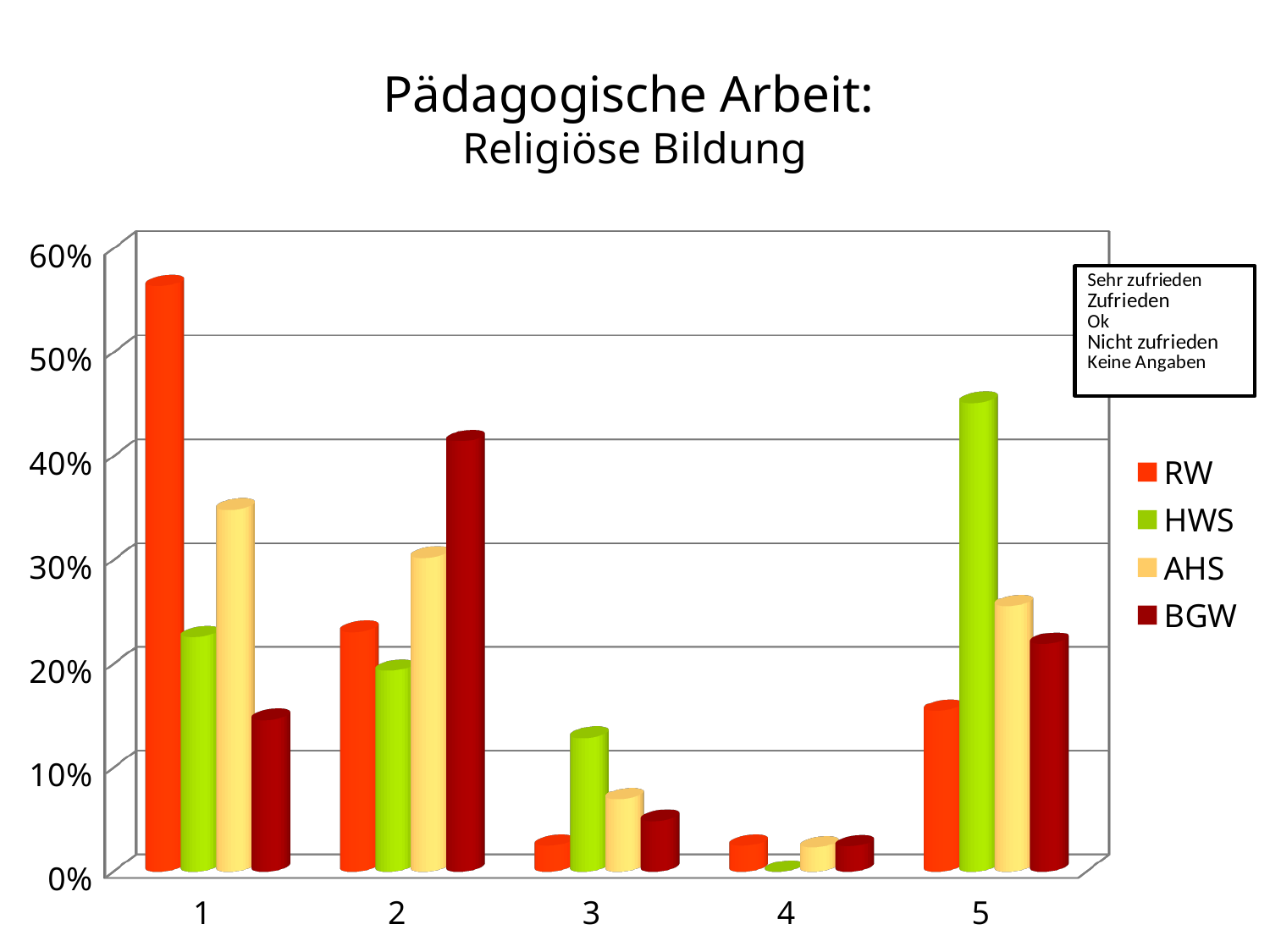
Which series has the highest value in category 5? HWS Which series has the highest value in category 2? BGW In category 5, which is larger: the value for AHS or the value for RW? AHS Is the value for RW in category 1 greater or less than 50%? greater How many categories are shown on the x axis? 5 Is the value for HWS in category 3 greater or less than 20%? less What kind of chart is shown on the slide? bar chart What is the title of the chart? Pädagogische Arbeit: Religiöse Bildung Which series has the lowest value in category 4? HWS Is the value for BGW in category 2 greater or less than 40%? greater Which series has the highest value in category 1? RW How many series does the legend list? 4